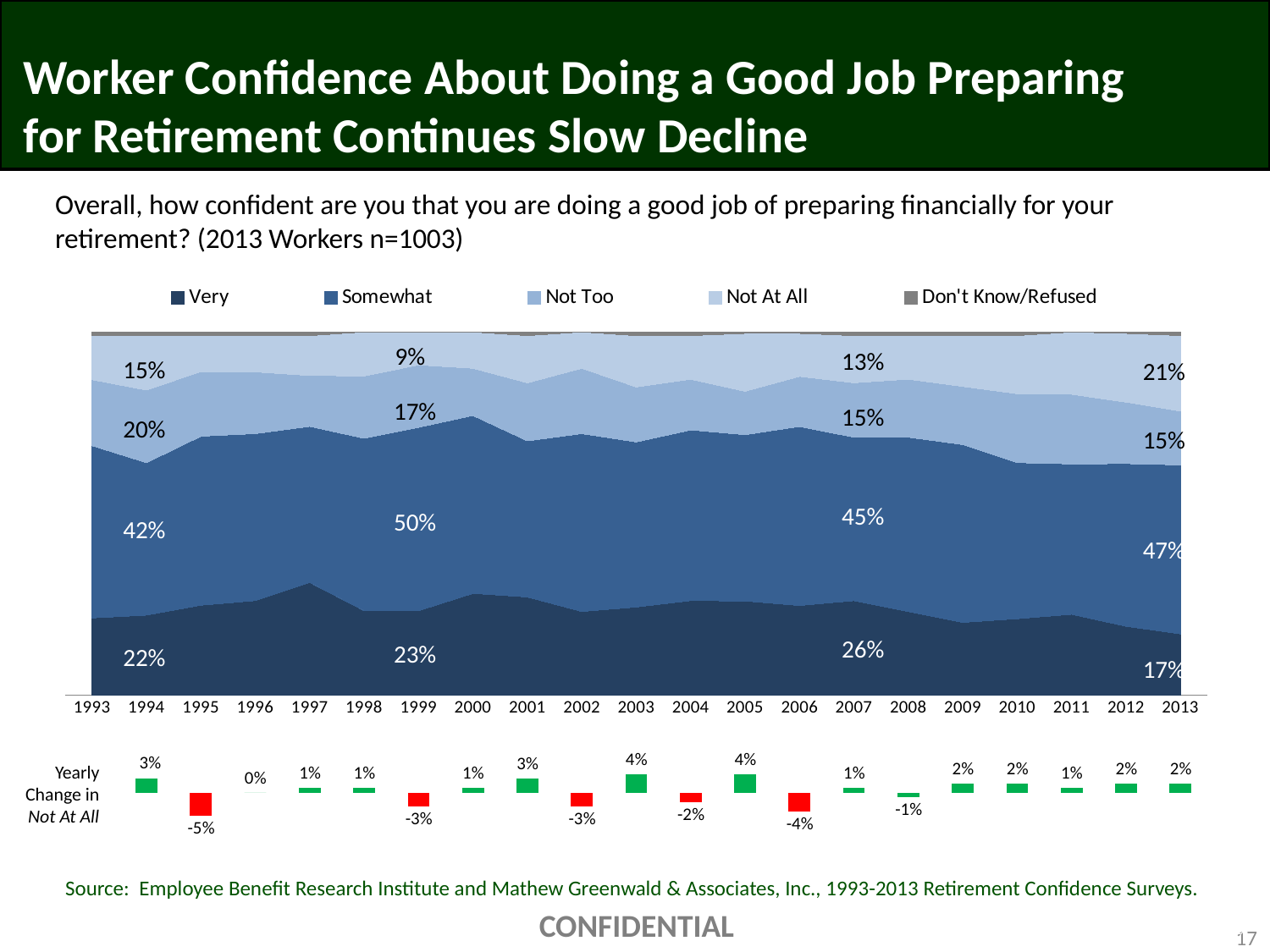
In the Yearly Change in Not At All bar chart, which year has the lowest value? 1995 What is the first entry in the legend of the main chart? Very What kind of chart is the main chart showing Very, Somewhat, Not Too and Not At All? Stacked area chart How many series does the legend of the stacked area chart list? 5 In the main chart, which is larger: the Very value in 2007 or in 2013? 2007 In the main chart, what is the value for Somewhat in 1999? 50% In the Yearly Change in Not At All bar chart, what is the value for 2006? -4% In the main chart, what is the value for Very in 2013? 17% In the main chart, what is the value for Not At All in 2013? 21% How many years are shown in the Yearly Change in Not At All bar chart? 20 In the Yearly Change in Not At All bar chart, what is the value for 1996? 0% In the main chart, by how many percentage points is Not At All higher in 2013 than in 1994? 6 percentage points